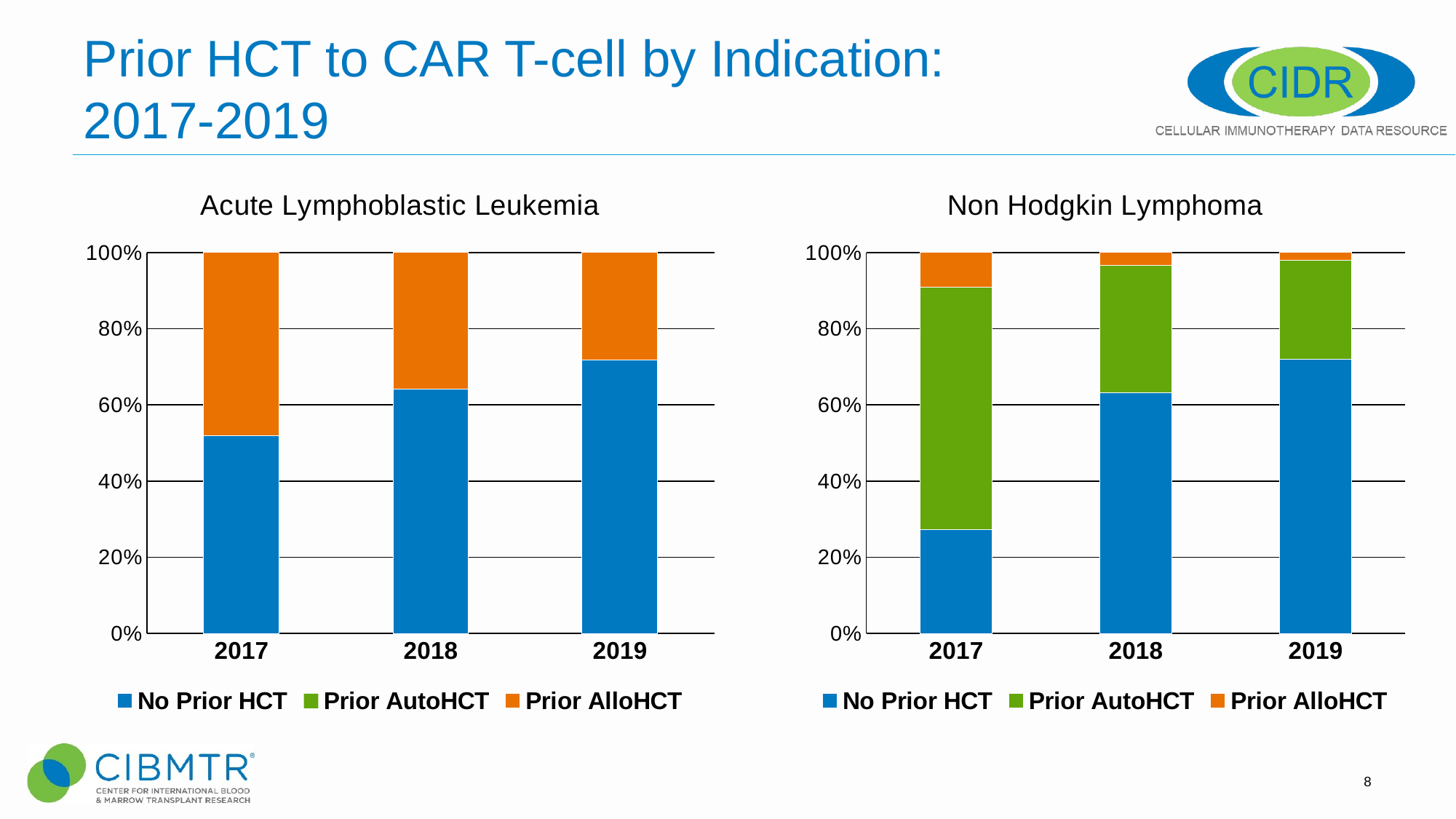
What kind of chart is the Acute Lymphoblastic Leukemia chart? Stacked bar chart In the Acute Lymphoblastic Leukemia chart, is the No Prior HCT share for 2017 greater or less than 60%? less In the Acute Lymphoblastic Leukemia chart, is the No Prior HCT share for 2019 greater or less than 60%? greater In the Non Hodgkin Lymphoma chart, which year has the lowest No Prior HCT share? 2017 How many years are shown on the x axis of the Acute Lymphoblastic Leukemia chart? 3 In the Non Hodgkin Lymphoma chart, does the Prior AutoHCT share rise or fall from 2017 to 2019? fall In the Acute Lymphoblastic Leukemia chart, does the No Prior HCT share rise or fall from 2017 to 2019? rise What colour represents Prior AlloHCT in the legend of the Acute Lymphoblastic Leukemia chart? Orange How many series does the legend of the Non Hodgkin Lymphoma chart list? 3 In the Non Hodgkin Lymphoma chart, is the No Prior HCT share for 2017 greater or less than 40%? less In the Non Hodgkin Lymphoma chart, which year has the highest No Prior HCT share? 2019 In the Non Hodgkin Lymphoma chart for 2017, which is larger: the Prior AutoHCT share or the Prior AlloHCT share? Prior AutoHCT